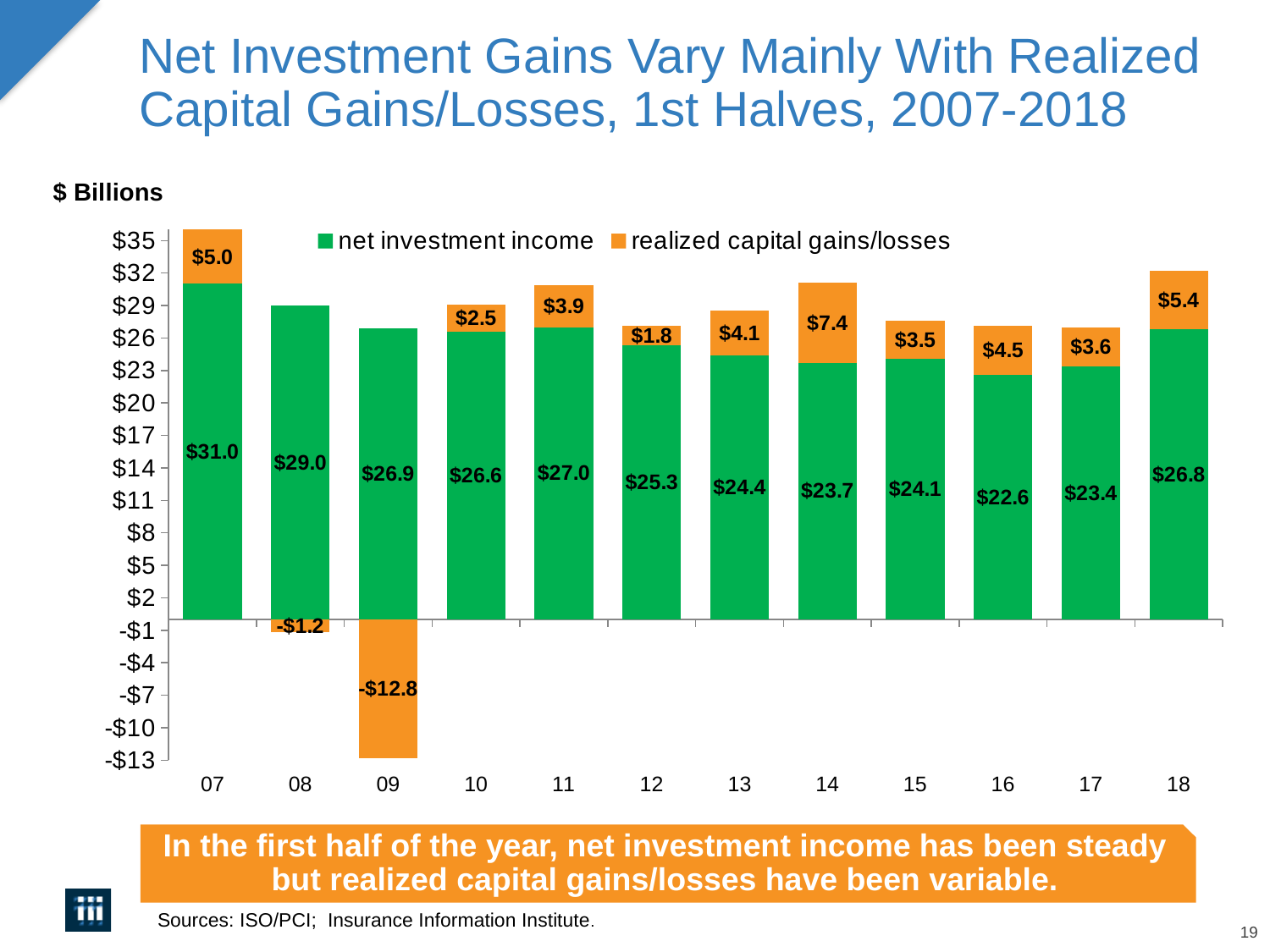
How many years are shown on the x axis? 12 Which year has the highest realized capital gains/losses? 14 Which year has the highest net investment income? 07 What is the net investment income for 14? $23.7 What is the difference between net investment income in 07 and in 18? $4.2 What is the value of realized capital gains/losses for 09? -$12.8 Which year has the lowest net investment income? 16 Which year has the lowest realized capital gains/losses? 09 What is the total of the stacked bar for 18 (net investment income plus realized capital gains/losses)? $32.2 Which year has larger realized capital gains/losses, 13 or 16? 16 What kind of chart is shown on the slide? Stacked bar chart How many series does the legend list? 2